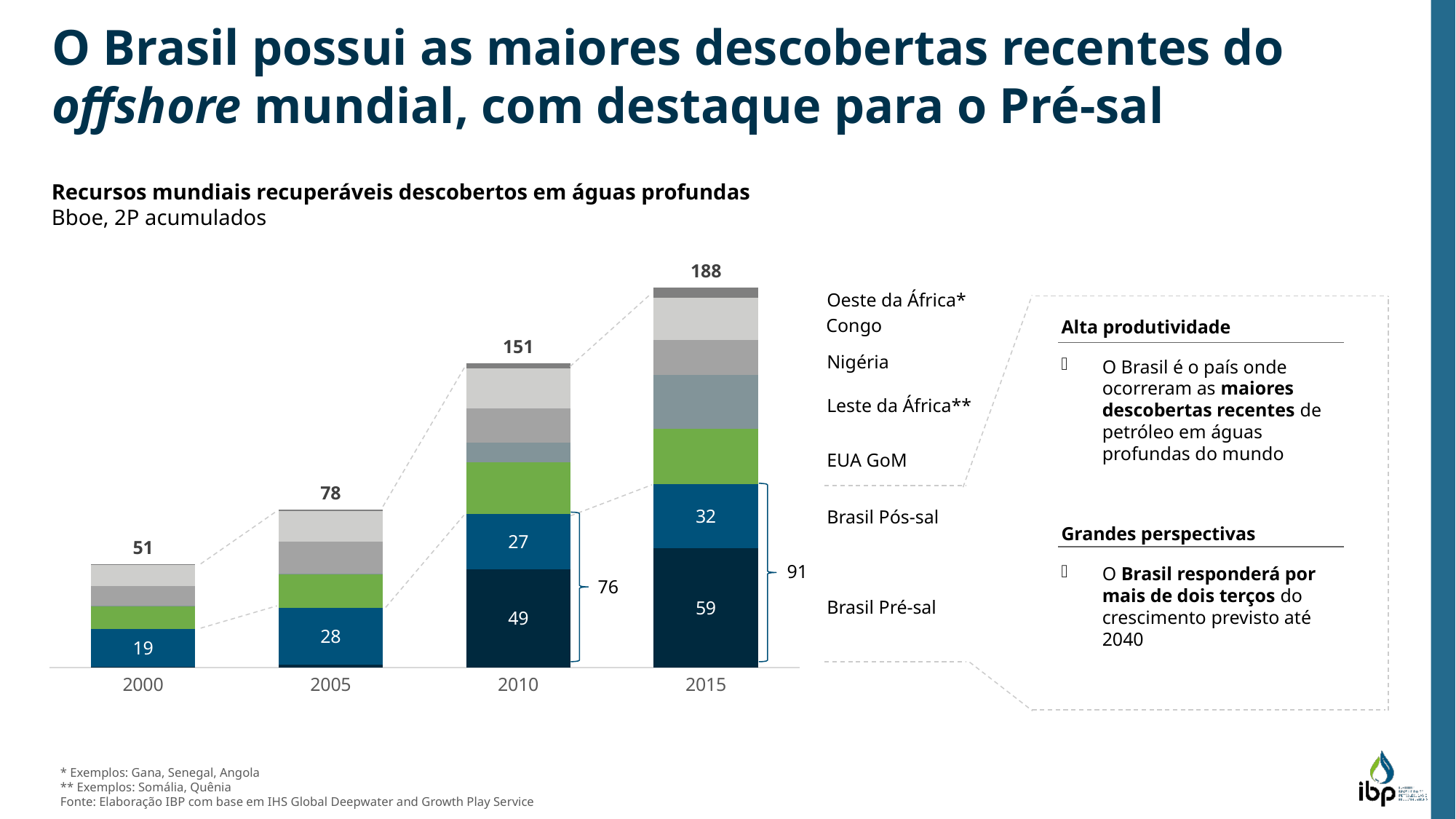
What is the total value of the stacked bar for 2015? 188 Which is larger, the Brasil Pré-sal value in 2015 or the Brasil Pós-sal value in 2015? Brasil Pré-sal What is the value for Brasil Pós-sal in 2015? 32 How many series does the legend list? 7 Which year has the highest total value? 2015 What is the value for Brasil Pré-sal in 2010? 49 What is the value for Brasil Pós-sal in 2005? 28 How many years are shown on the x axis? 4 What is the difference between the total for 2015 and the total for 2010? 37 Do the total values rise or fall from 2000 to 2015? rise Which year has the lowest total value? 2000 What is the total value of the stacked bar for 2000? 51